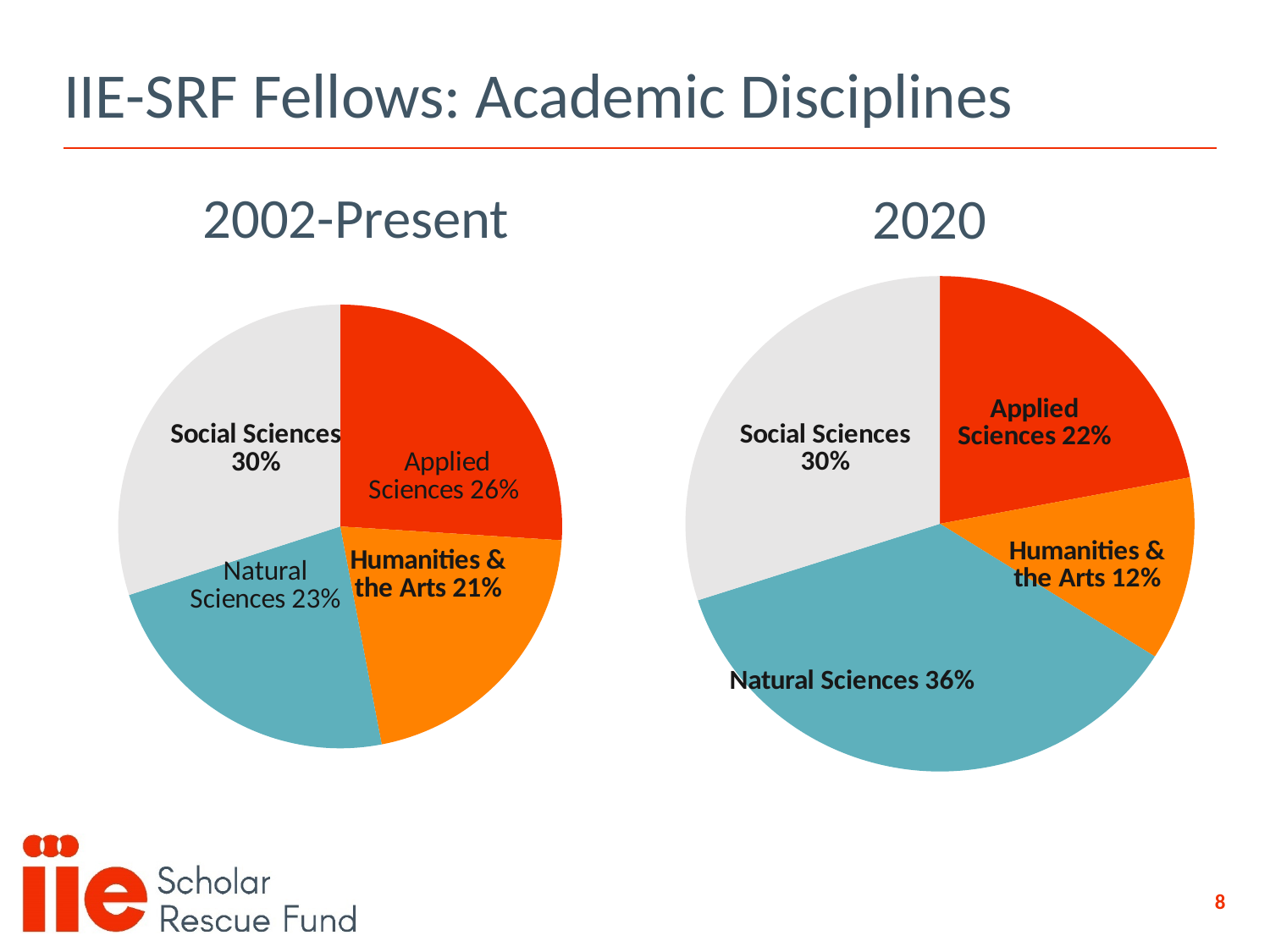
In the 2002-Present pie chart, which discipline has the largest share? Social Sciences What colour is the Natural Sciences slice in the 2020 pie chart? Teal In the 2002-Present pie chart, what share do Social Sciences have? 30% In the 2002-Present pie chart, what share do Natural Sciences have? 23% In the 2020 pie chart, which discipline has the largest share? Natural Sciences How many disciplines are shown in the 2020 pie chart? 4 What is the difference between the Applied Sciences share in the 2002-Present chart and in the 2020 chart? 4% What kind of chart is used for the 2002-Present data? Pie chart In the 2020 pie chart, what share do Humanities & the Arts have? 12% Which is larger: the Natural Sciences share in the 2002-Present chart or in the 2020 chart? 2020 In the 2020 pie chart, what share do Natural Sciences have? 36% In the 2020 pie chart, which discipline has the smallest share? Humanities & the Arts